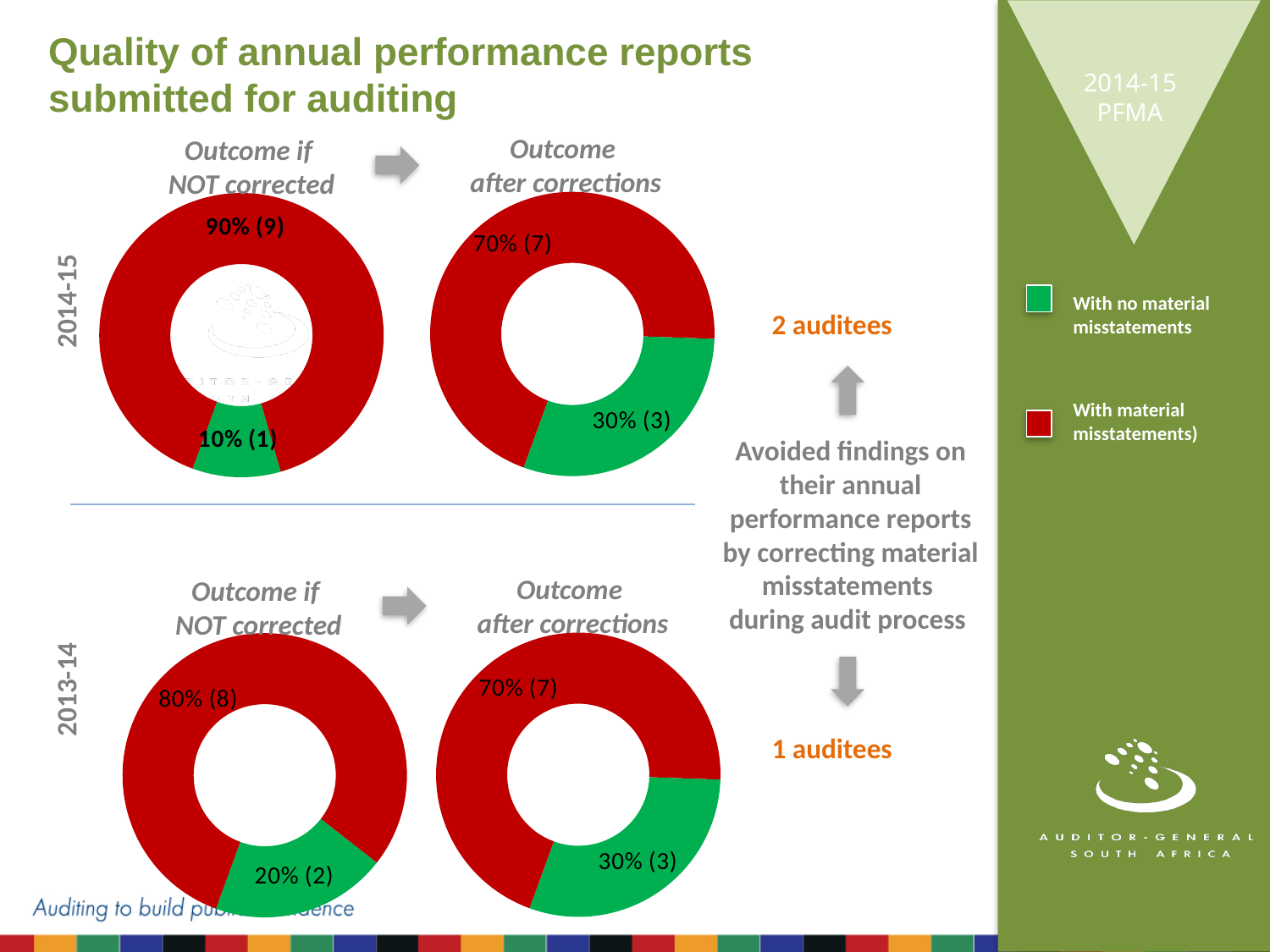
What is the difference in percentage points between the 'with material misstatements' share in the 2014-15 'Outcome if NOT corrected' chart and the 2014-15 'Outcome after corrections' chart? 20 percentage points In the 2014-15 'Outcome after corrections' chart, what share of auditees had no material misstatements? 30% (3) Which is larger: the 'with no material misstatements' share in the 2013-14 'Outcome if NOT corrected' chart or in the 2014-15 'Outcome if NOT corrected' chart? 2013-14 'Outcome if NOT corrected' In the 2013-14 'Outcome after corrections' chart, what share of auditees had material misstatements? 70% (7) In the 2014-15 'Outcome if NOT corrected' chart, what share of auditees had material misstatements? 90% (9) In the 2013-14 'Outcome if NOT corrected' chart, what share of auditees had material misstatements? 80% (8) In the 2014-15 'Outcome if NOT corrected' chart, what share of auditees had no material misstatements? 10% (1) What type of chart is used to show the quality of annual performance reports on this slide? Donut (pie) chart Which colour represents 'With material misstatements' in the legend? Red In the 2013-14 'Outcome if NOT corrected' chart, which category is the largest slice? With material misstatements In the 2014-15 'Outcome after corrections' chart, which category is the smallest slice? With no material misstatements How many donut charts are shown on the slide? 4